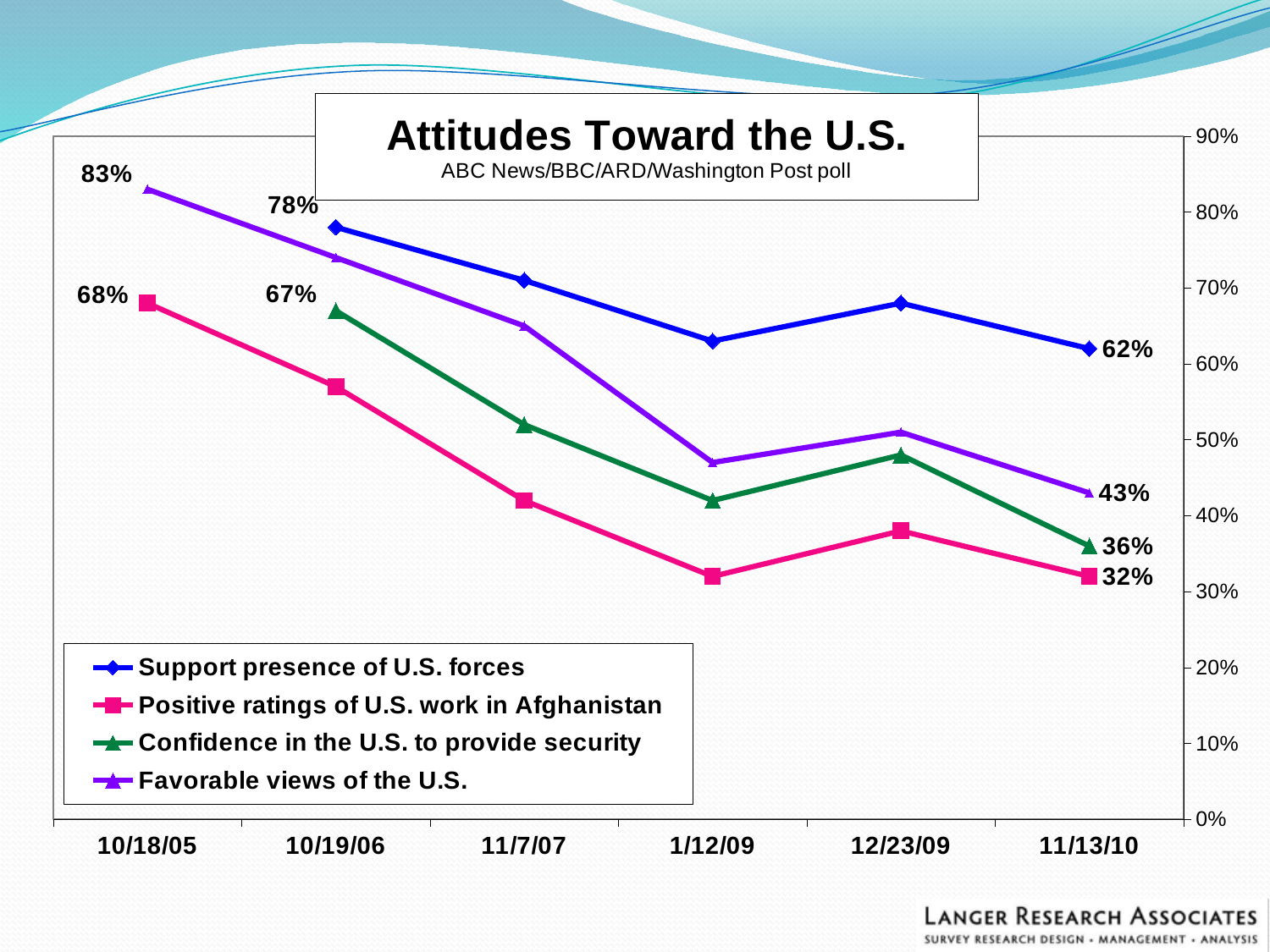
What was the value for Positive ratings of U.S. work in Afghanistan on 11/13/10? 32% What was the value for Confidence in the U.S. to provide security on 10/19/06? 67% By how many percentage points did Favorable views of the U.S. fall from 10/18/05 to 11/13/10? 40 percentage points How many series does the legend list? 4 Is the value for Favorable views of the U.S. on 1/12/09 greater or less than 40%? greater What was the value for Support presence of U.S. forces on 11/13/10? 62% Did Positive ratings of U.S. work in Afghanistan rise or fall from 10/18/05 to 1/12/09? Fall What kind of chart is shown on the slide? Line chart Which series has the lowest value on 11/13/10? Positive ratings of U.S. work in Afghanistan Which series has the highest value on 11/13/10? Support presence of U.S. forces What was the value for Favorable views of the U.S. on 10/18/05? 83% How many poll dates are shown along the x axis? 6